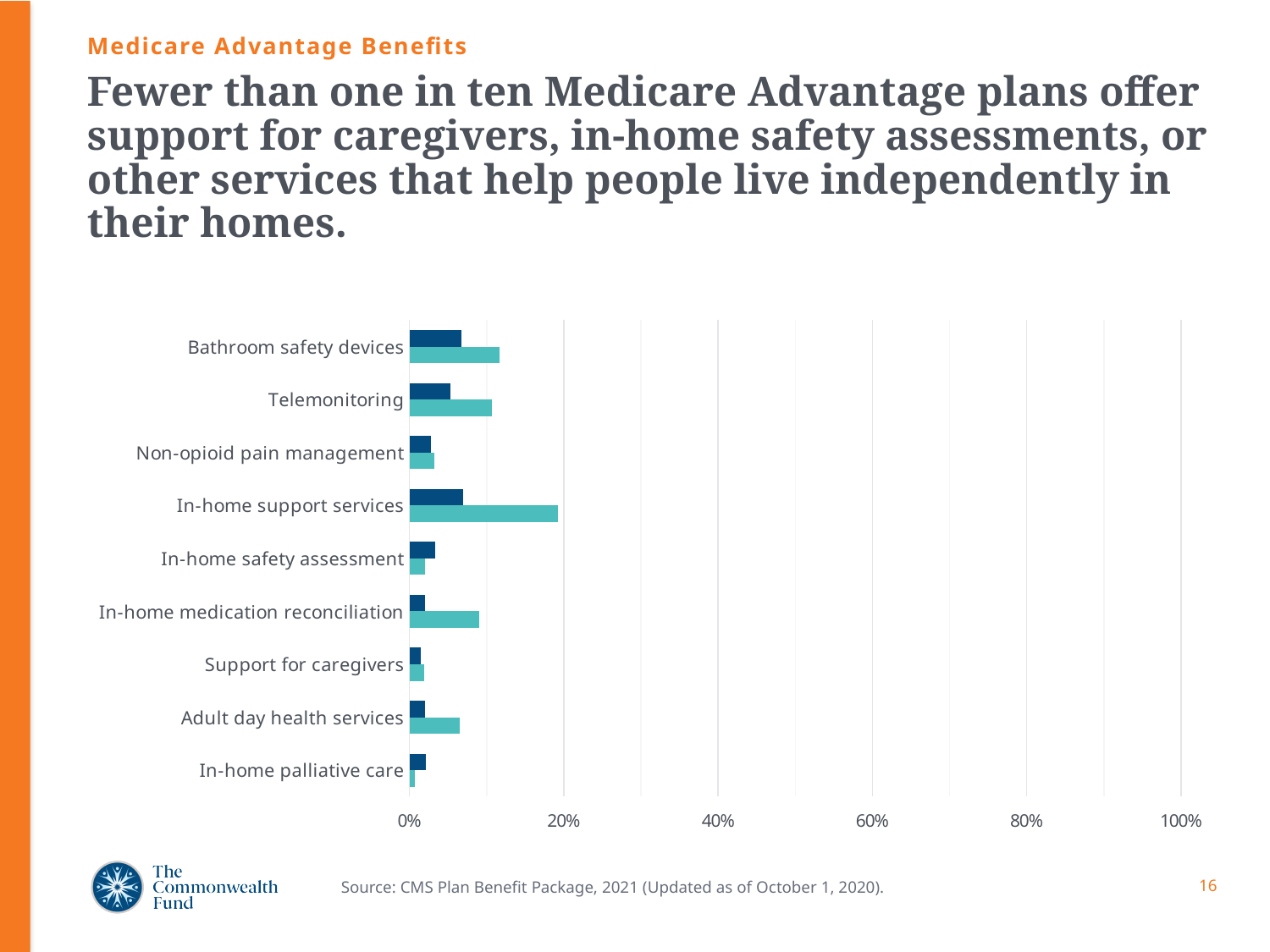
What kind of chart is shown on the slide? Bar chart Which category is listed first (at the top) of the chart? Bathroom safety devices Is the dark blue bar for Bathroom safety devices greater or less than 10%? less Which is larger: the teal bar for In-home support services or the teal bar for Bathroom safety devices? In-home support services Which category has the shortest teal bar on the chart? In-home palliative care How many categories (benefit types) are listed on the chart? 9 Is the teal bar for In-home support services greater or less than 10%? greater Which category has the longest teal bar on the chart? In-home support services Is the teal bar for Non-opioid pain management greater or less than 10%? less What is the highest value shown on the horizontal axis of the chart? 100% Which is larger: the teal bar for In-home medication reconciliation or the teal bar for Support for caregivers? In-home medication reconciliation